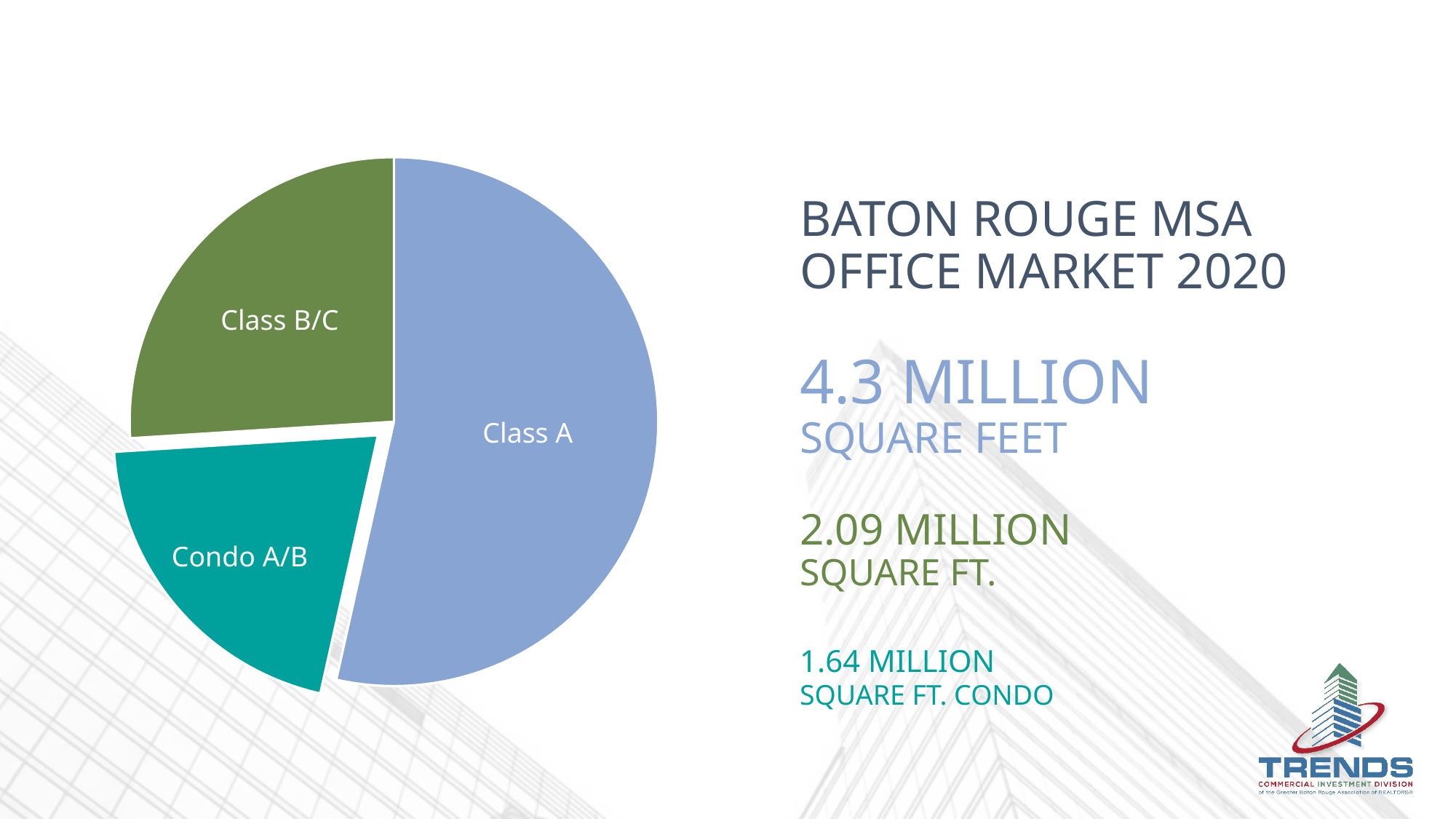
Which slice of the pie chart is the largest? Class A How many square feet does the slide give for Class A office space? 4.3 million How many slices does the pie chart have? 3 What colour is the Condo A/B slice of the pie chart? Teal Which slice is larger, Class A or Class B/C? Class A How many square feet does the slide give for Class B/C office space? 2.09 million Which slice of the pie chart is the smallest? Condo A/B What is the title shown next to the pie chart? Baton Rouge MSA Office Market 2020 What is the difference in square feet between Class A and Class B/C? 2.21 million What kind of chart is shown on the slide? Pie chart Which slice is larger, Class B/C or Condo A/B? Class B/C How many square feet does the slide give for Condo A/B office space? 1.64 million